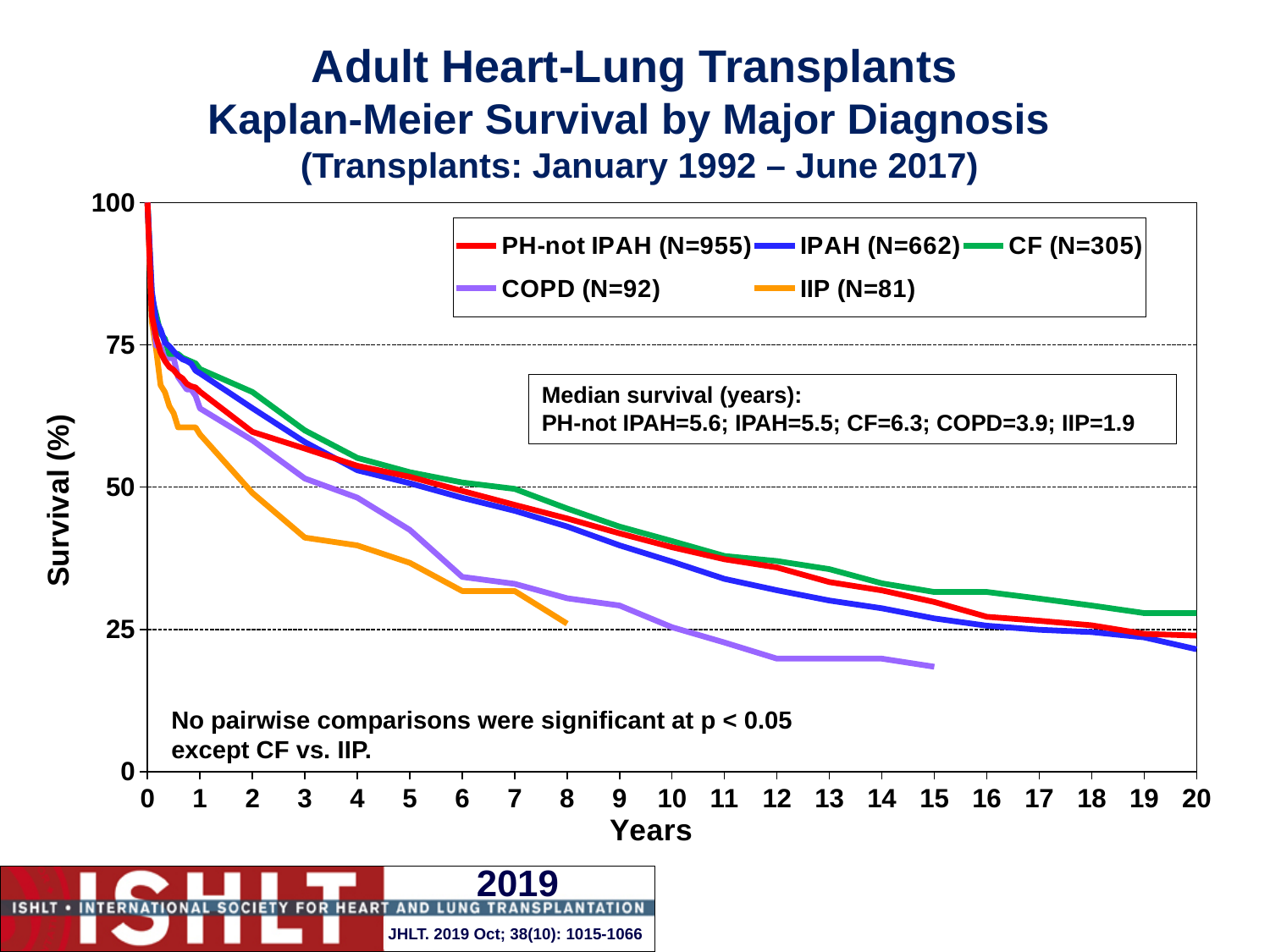
Which diagnosis group has the lowest median survival? IIP What is the difference in median survival (years) between CF and IIP? 4.4 How many series does the legend list? 5 Which has the larger median survival, COPD or IIP? COPD What is the median survival in years for CF? 6.3 Which diagnosis group has the highest median survival? CF Is the survival value for COPD at 15 years greater or less than 25? less What is the N for the PH-not IPAH group shown in the legend? 955 What is the median survival in years for IIP? 1.9 What kind of chart is shown on the slide? Line chart Is the survival value for IIP at 5 years greater or less than 50? less Do the survival curves rise or fall as years increase? Fall